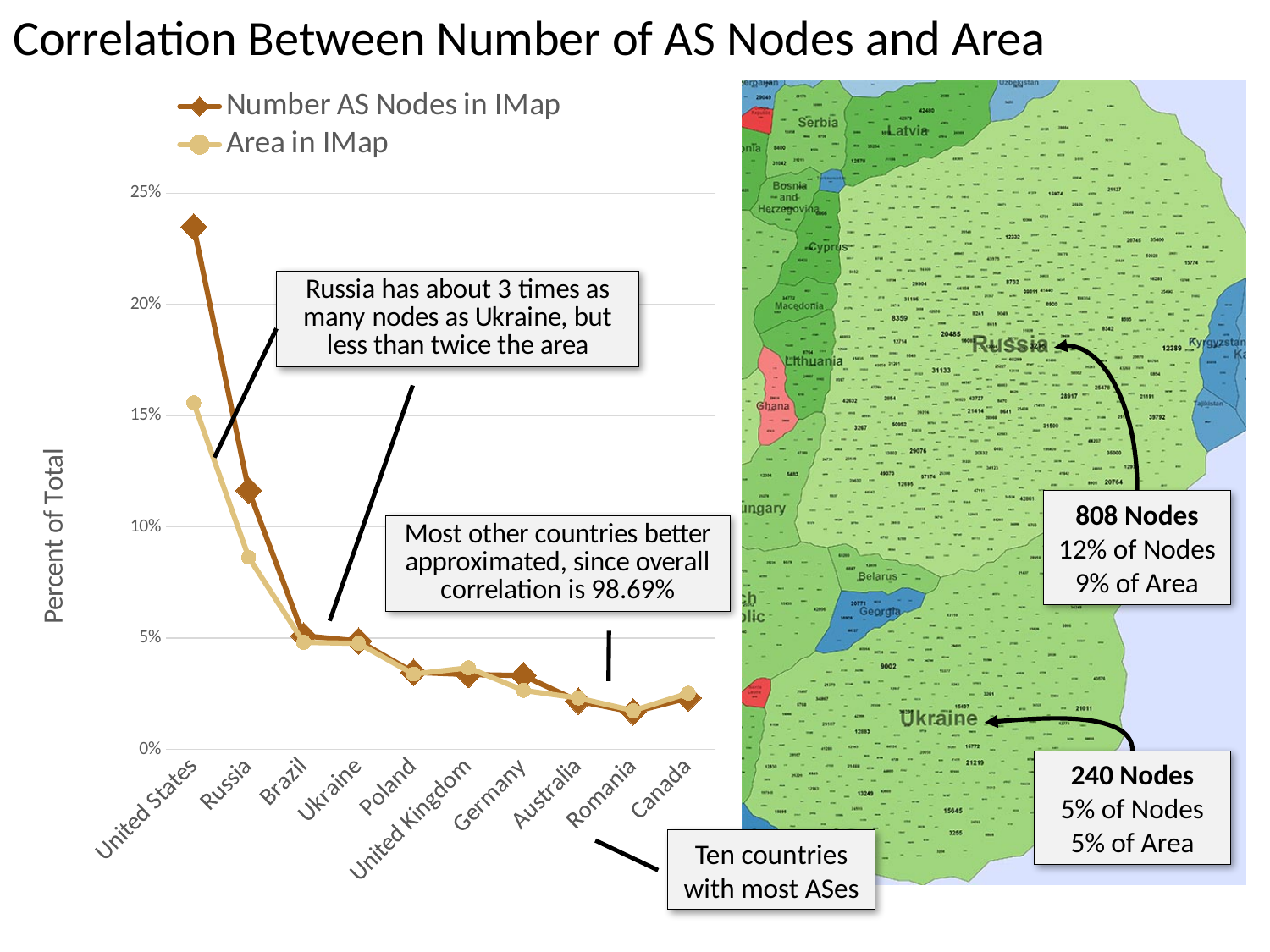
Which country has the lowest value for Number AS Nodes in IMap? Romania How many countries are plotted along the x axis of the chart? 10 What is the label of the y axis of the chart? Percent of Total Is the Area in IMap value for United States greater or less than 20%? less How many series does the chart legend list? 2 Which country has the highest value for Number AS Nodes in IMap? United States What kind of chart is shown on the slide? line chart Do the Number AS Nodes in IMap values generally rise or fall from United States to Canada along the x axis? fall Which is larger, the Number AS Nodes in IMap value for United States or for Russia? United States Is the Number AS Nodes in IMap value for United States greater or less than 20%? greater Is the Number AS Nodes in IMap value for Brazil greater or less than 10%? less